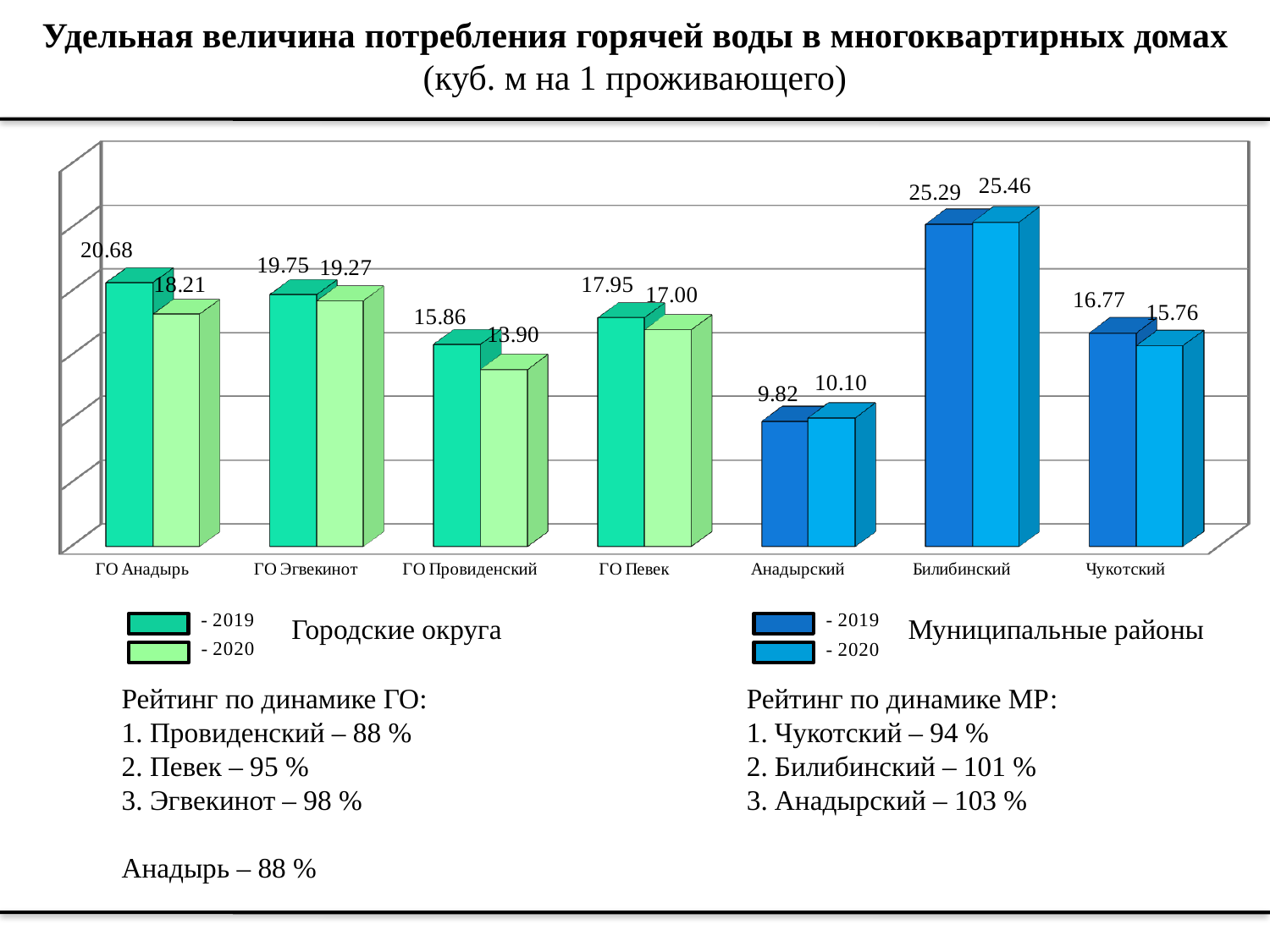
Which two years are listed in the legend for Городские округа? 2019 and 2020 What kind of chart is shown on the slide? Bar chart Which is larger for Анадырский: the 2019 value or the 2020 value? 2020 How many categories are shown on the x axis? 7 What is the 2019 value for ГО Анадырь? 20.68 Which category has the lowest 2019 value? Анадырский What is the 2020 value for ГО Провиденский? 13.90 What is the difference between the 2019 and 2020 values for ГО Анадырь? 2.47 Which category has the highest 2020 value? Билибинский What is the 2019 value for Чукотский? 16.77 What is the 2020 value for Билибинский? 25.46 What is the difference between the 2020 values of Билибинский and Анадырский? 15.36